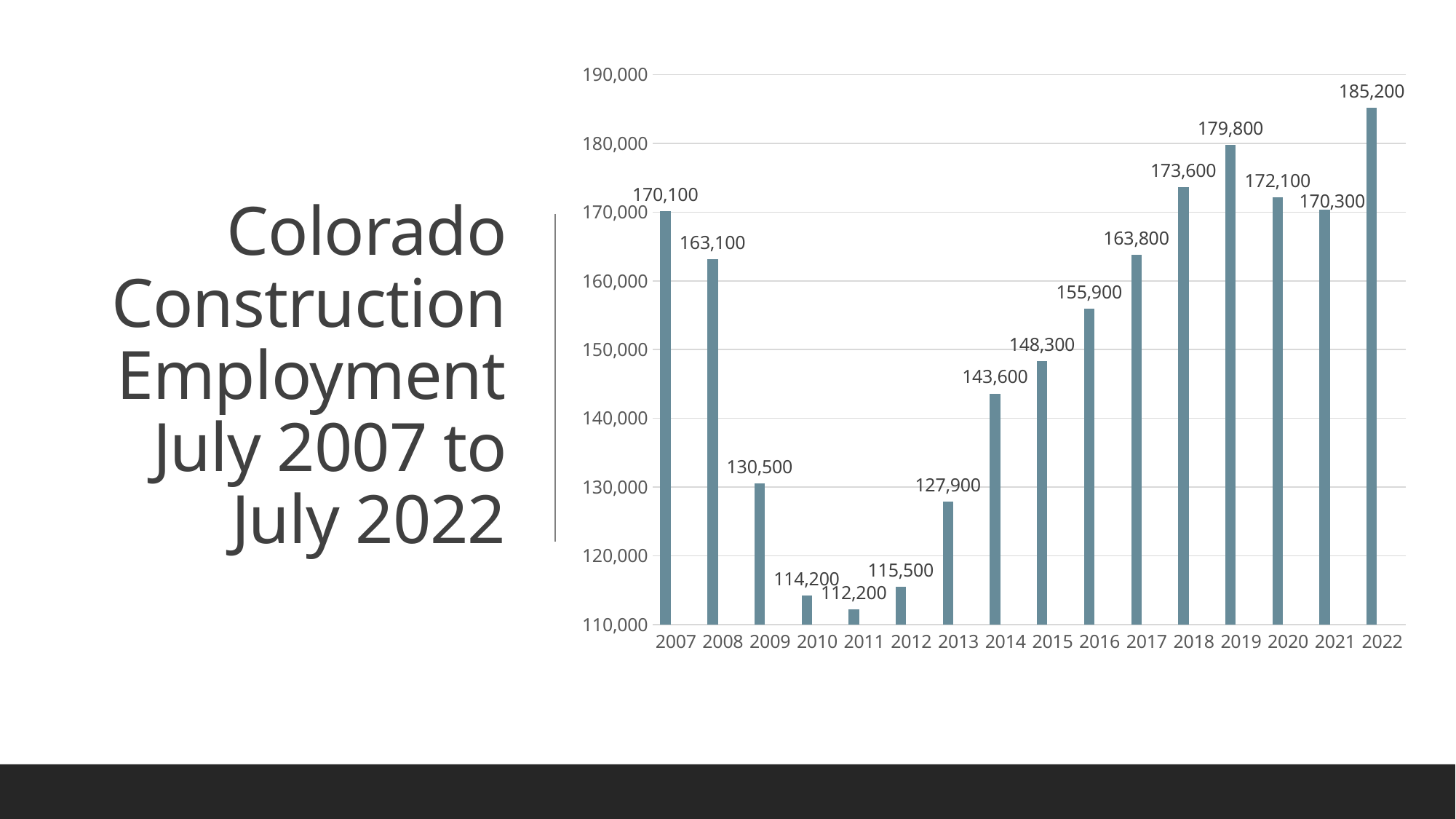
What is the difference between the 2022 value and the 2007 value? 15,100 Which year has the lowest construction employment value? 2011 What kind of chart is shown on the slide? bar chart How many years are shown on the x axis? 16 What is the difference between the 2019 value and the 2020 value? 7,700 Do the values rise or fall from 2011 to 2019? rise Which year has the highest construction employment value? 2022 Which is larger, the value for 2008 or the value for 2017? 2017 What was Colorado construction employment in July 2019? 179,800 Is the value for 2013 greater or less than 130,000? less What was Colorado construction employment in July 2011? 112,200 What was Colorado construction employment in July 2007? 170,100